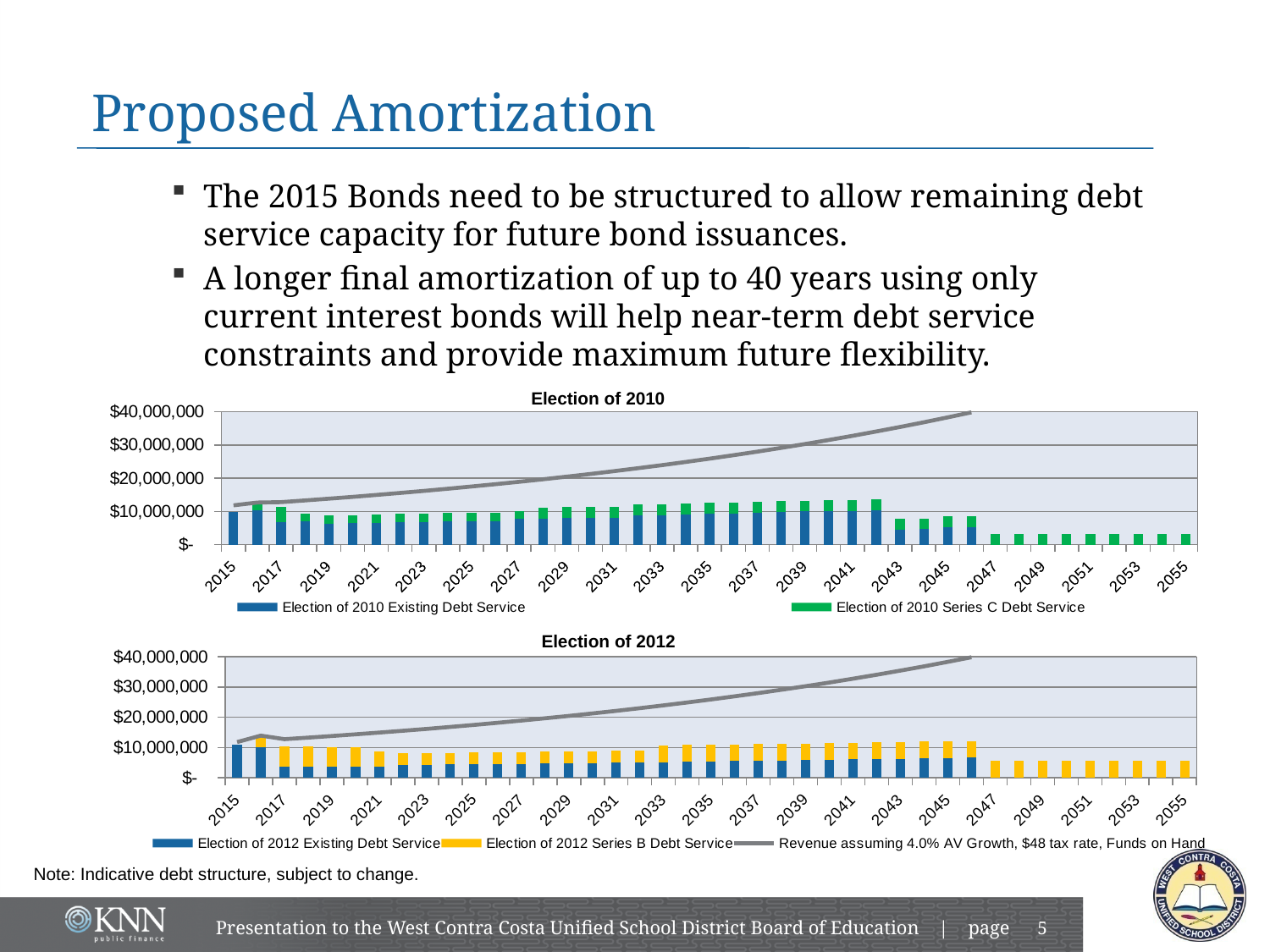
How many series does the legend of the 'Election of 2010' chart list? 2 What kind of chart is the 'Election of 2010' chart? combination bar and line chart In the 'Election of 2012' chart, does the revenue line rise or fall from 2015 to 2047? rise In the 'Election of 2010' chart, is the total debt service bar for 2041 greater or less than $10,000,000? greater In the 'Election of 2012' chart, is the total debt service bar for 2049 greater or less than $10,000,000? less In the 'Election of 2010' chart, which year has the larger total debt service bar, 2041 or 2049? 2041 How many series does the legend of the 'Election of 2012' chart list? 3 What is the title of the lower chart on the slide? Election of 2012 In the 'Election of 2012' chart, is the total debt service bar for 2045 greater or less than $10,000,000? greater In the 'Election of 2012' chart, which year has the larger total debt service bar, 2045 or 2025? 2045